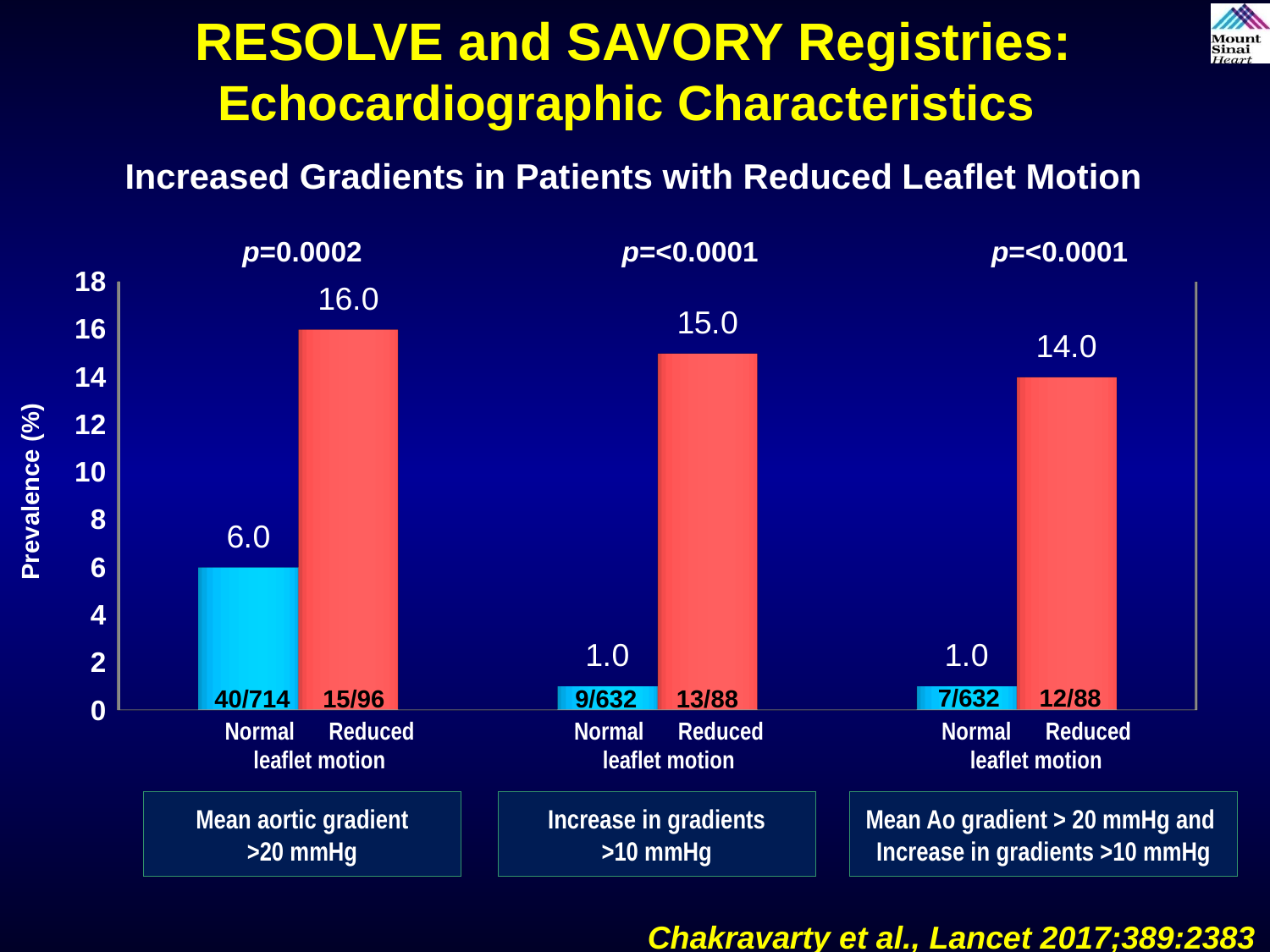
Which bar has the highest prevalence on the chart? Reduced leaflet motion, Mean aortic gradient >20 mmHg (16.0) What type of chart is shown on the slide? Bar chart What is the prevalence (%) for Reduced leaflet motion in the 'Mean aortic gradient >20 mmHg' group? 16.0 What is the prevalence (%) for Reduced leaflet motion in the 'Mean Ao gradient > 20 mmHg and Increase in gradients >10 mmHg' group? 14.0 What is the difference in prevalence between Reduced and Normal leaflet motion in the 'Increase in gradients >10 mmHg' group? 14.0 How many bars are plotted on the chart? 6 What p-value is shown above the 'Mean aortic gradient >20 mmHg' group? p=0.0002 What is the prevalence (%) for Normal leaflet motion in the 'Mean aortic gradient >20 mmHg' group? 6.0 Which is larger: the Reduced leaflet motion prevalence in the 'Increase in gradients >10 mmHg' group or in the 'Mean Ao gradient > 20 mmHg and Increase in gradients >10 mmHg' group? Increase in gradients >10 mmHg (15.0) What is the difference in prevalence between Reduced and Normal leaflet motion in the 'Mean aortic gradient >20 mmHg' group? 10.0 What is the prevalence (%) for Reduced leaflet motion in the 'Increase in gradients >10 mmHg' group? 15.0 What fraction is printed on the Normal leaflet motion bar in the 'Increase in gradients >10 mmHg' group? 9/632